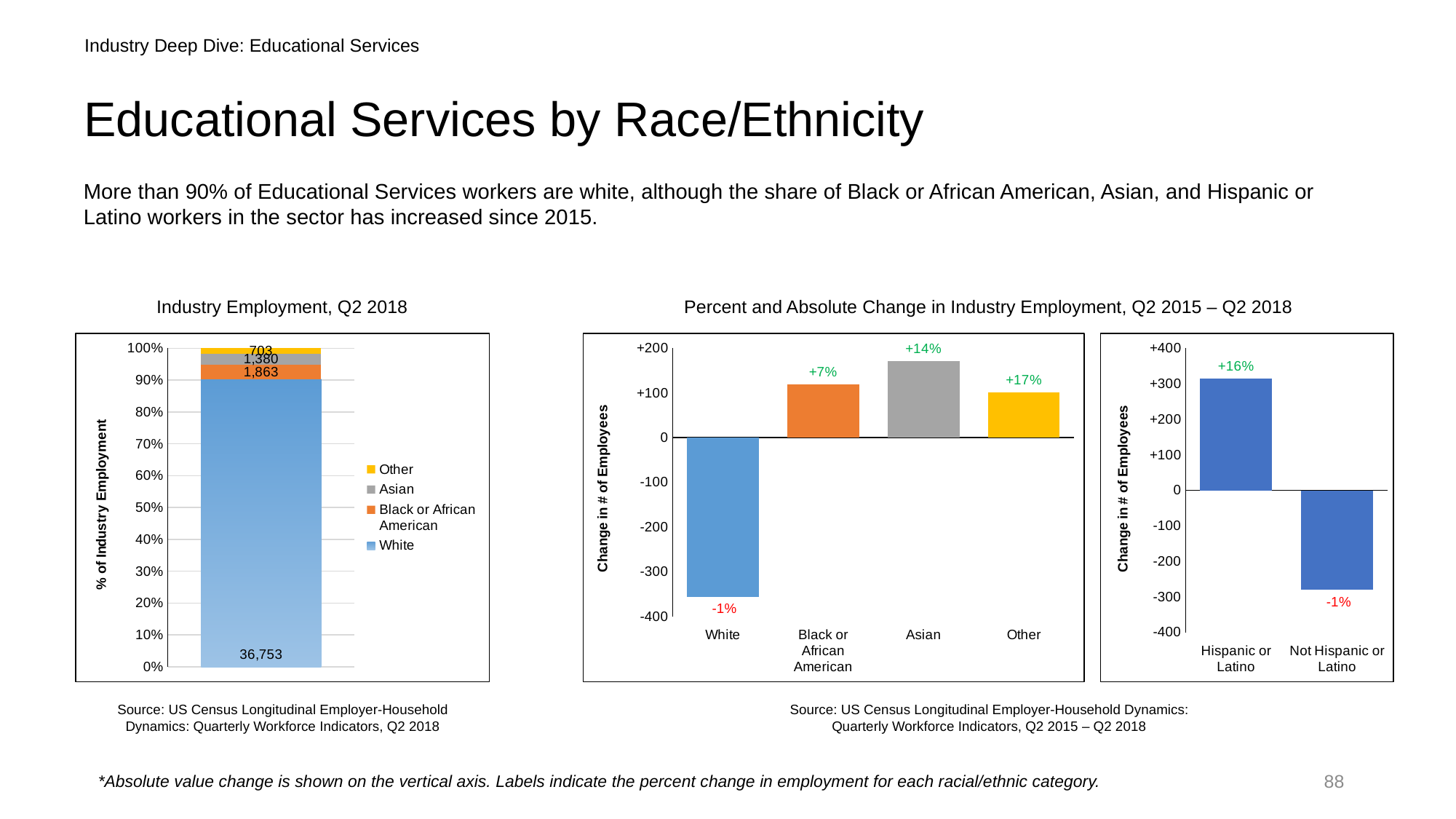
In the right-hand chart (change in employment by Hispanic or Latino status), what percent change label is shown for Hispanic or Latino? +16% In the middle chart (Percent and Absolute Change in Industry Employment by race), how many categories are shown on the x axis? 4 In the Industry Employment, Q2 2018 chart, what is the value shown for Other? 703 How many series does the legend of the Industry Employment, Q2 2018 chart list? 4 In the middle chart (Percent and Absolute Change in Industry Employment by race), is the change in number of employees for White greater or less than -300? less In the right-hand chart (change in employment by Hispanic or Latino status), is the change in number of employees for Not Hispanic or Latino greater or less than -200? less In the Industry Employment, Q2 2018 chart, what is the value shown for White? 36,753 In the Industry Employment, Q2 2018 chart, what is the value shown for Asian? 1,380 In the Industry Employment, Q2 2018 chart, what is the difference between the Black or African American value and the Asian value? 483 In the Industry Employment, Q2 2018 chart, what is the total of all four segments of the stacked bar? 40,699 In the middle chart (Percent and Absolute Change in Industry Employment by race), what percent change label is shown for Asian? +14% In the middle chart (Percent and Absolute Change in Industry Employment by race), which category has the lowest change in number of employees? White